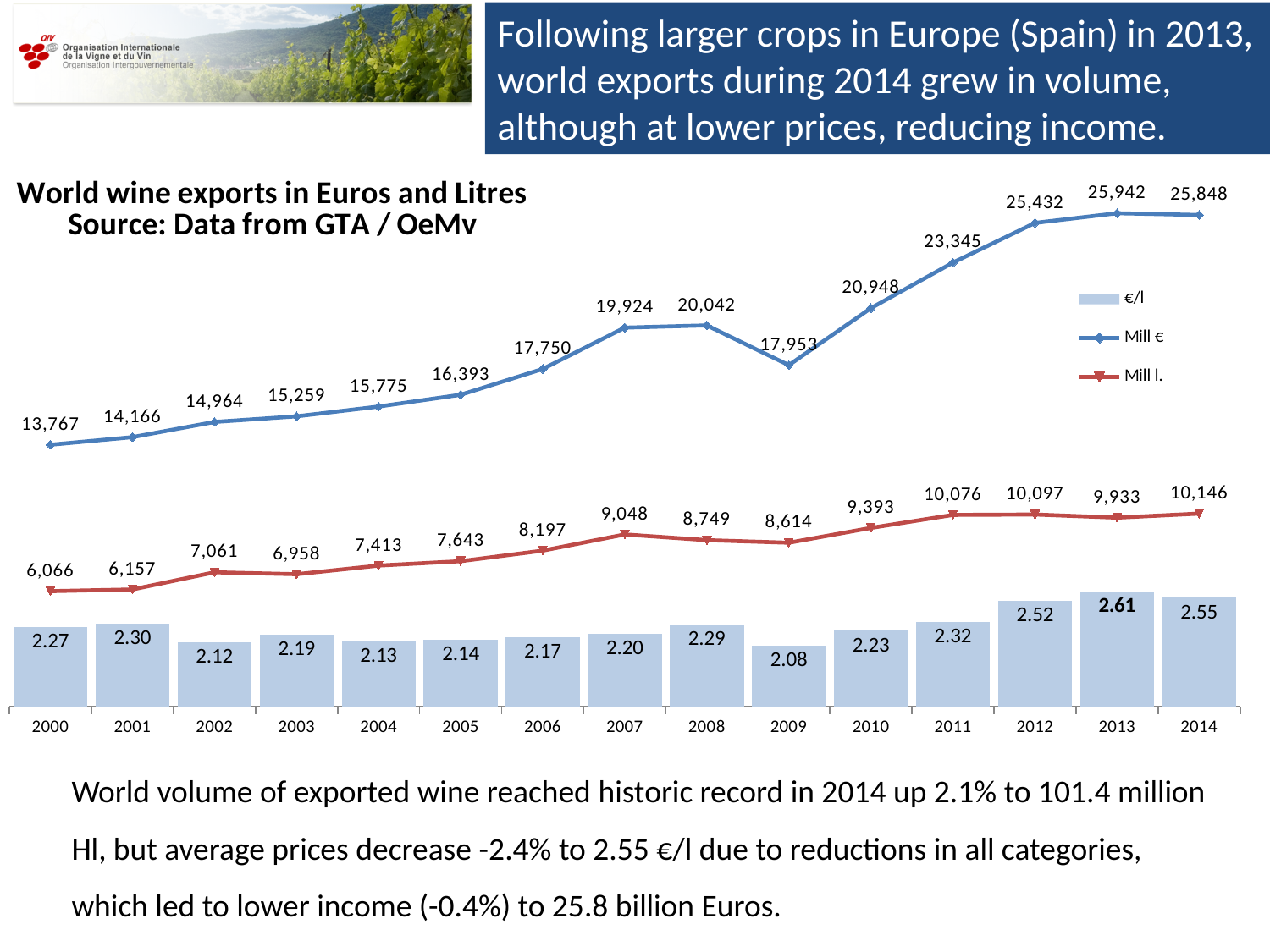
In which year is the Mill l. series highest? 2014 What is the Mill l. value for 2009? 8,614 In which year is the Mill € series highest? 2013 Does the Mill l. series generally rise or fall from 2000 to 2014? Rise What is the difference between the Mill € values for 2014 and 2000? 12,081 What is the Mill € value for 2013? 25,942 Which year has the larger Mill € value, 2008 or 2009? 2008 In which year is the €/l value lowest? 2009 How many series does the legend list? 3 How many years are shown on the x axis? 15 What kind of chart is this? Combined bar and line chart What is the €/l value for 2014? 2.55